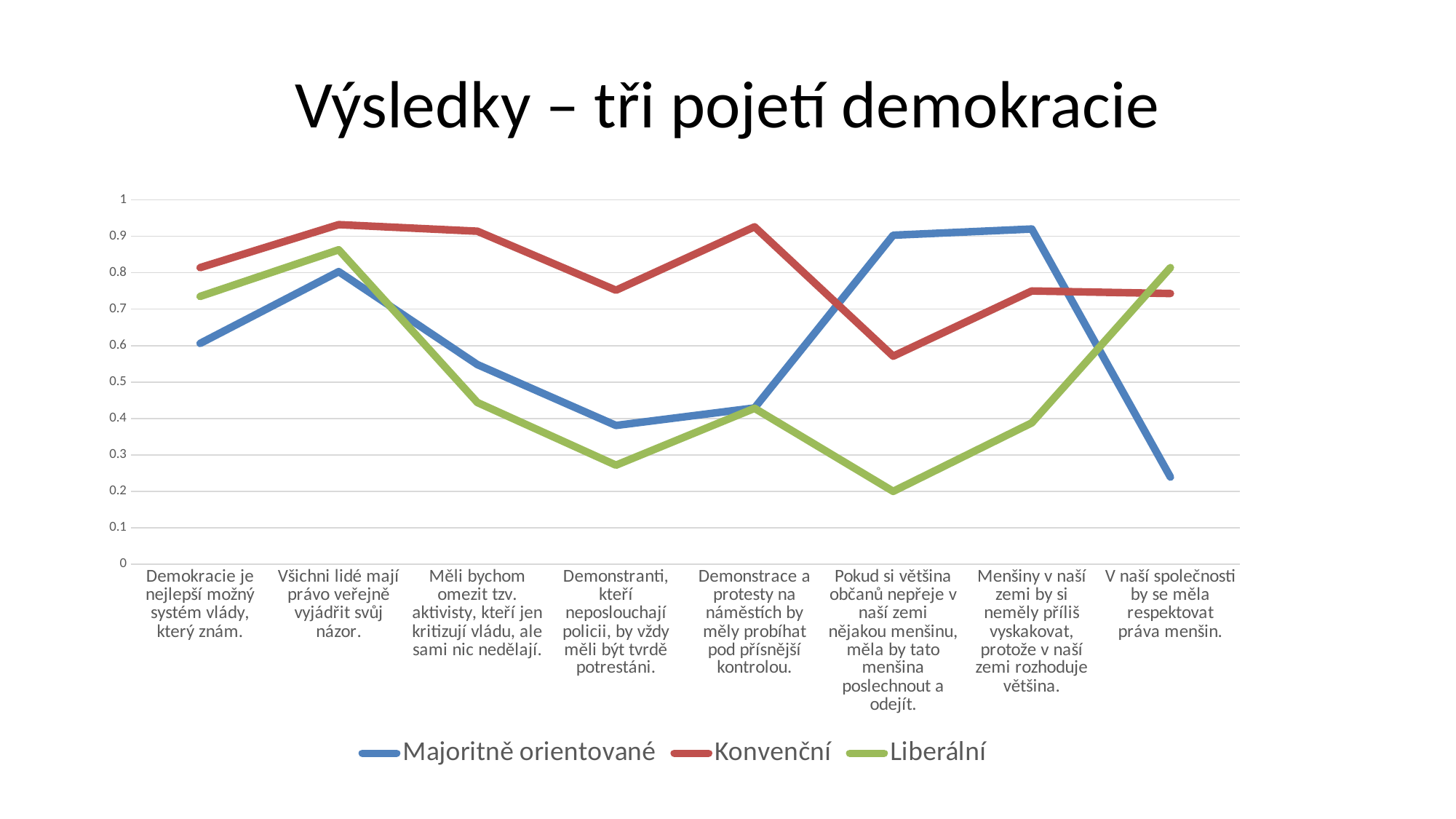
At "Demonstranti, kteří neposlouchají policii, by vždy měli být tvrdě potrestáni.", which series has the larger value, Konvenční or Liberální? Konvenční Is the value for Liberální at "Pokud si většina občanů nepřeje v naší zemi nějakou menšinu, měla by tato menšina poslechnout a odejít." greater or less than 0.3? less What kind of chart is shown on the slide? line chart What colour is the line for the Liberální series? green How many categories are plotted along the x axis? 8 Is the value for Majoritně orientované at "V naší společnosti by se měla respektovat práva menšin." greater or less than 0.3? less At "Demokracie je nejlepší možný systém vlády, který znám.", which series has the larger value, Majoritně orientované or Liberální? Liberální For the Liberální series, which category has the lowest value? Pokud si většina občanů nepřeje v naší zemi nějakou menšinu, měla by tato menšina poslechnout a odejít. How many series does the legend list? 3 Is the value for Majoritně orientované at "Pokud si většina občanů nepřeje v naší zemi nějakou menšinu, měla by tato menšina poslechnout a odejít." greater or less than 0.8? greater For the Konvenční series, which category has the lowest value? Pokud si většina občanů nepřeje v naší zemi nějakou menšinu, měla by tato menšina poslechnout a odejít.